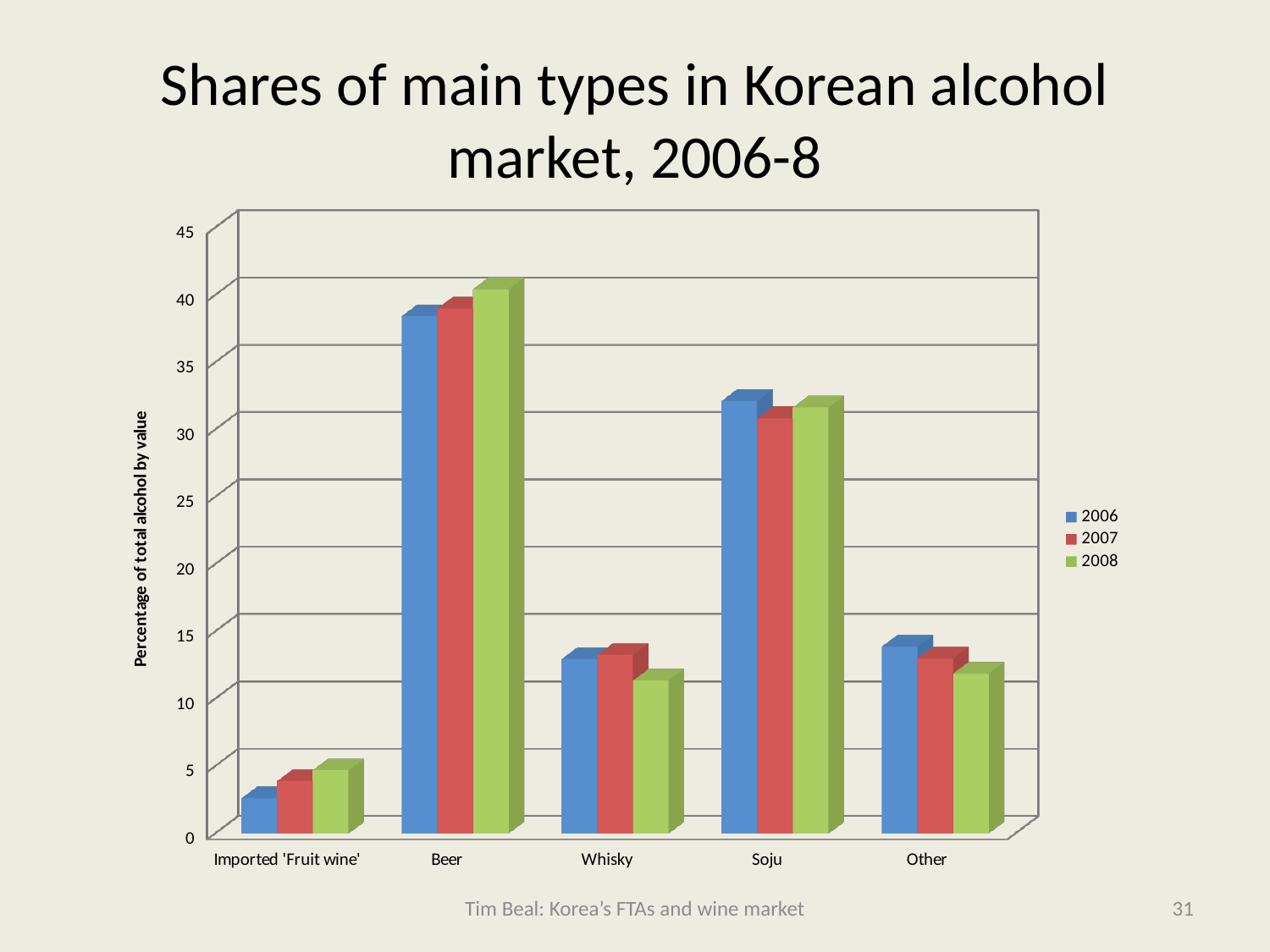
How many categories are shown on the x axis of the chart? 5 Which category has the lowest share in 2006? Imported 'Fruit wine' What is the label on the vertical axis of the chart? Percentage of total alcohol by value Is the value for Imported 'Fruit wine' in 2006 greater or less than 5? less What kind of chart is shown on the slide? bar chart How many series does the legend list? 3 Is the value for Soju in 2006 greater or less than 30? greater Does the share of Imported 'Fruit wine' rise or fall from 2006 to 2008? rise Which category has the highest share in 2008? Beer Which is larger in 2007, the share for Soju or the share for Whisky? Soju Is the value for Other in 2006 greater or less than 15? less